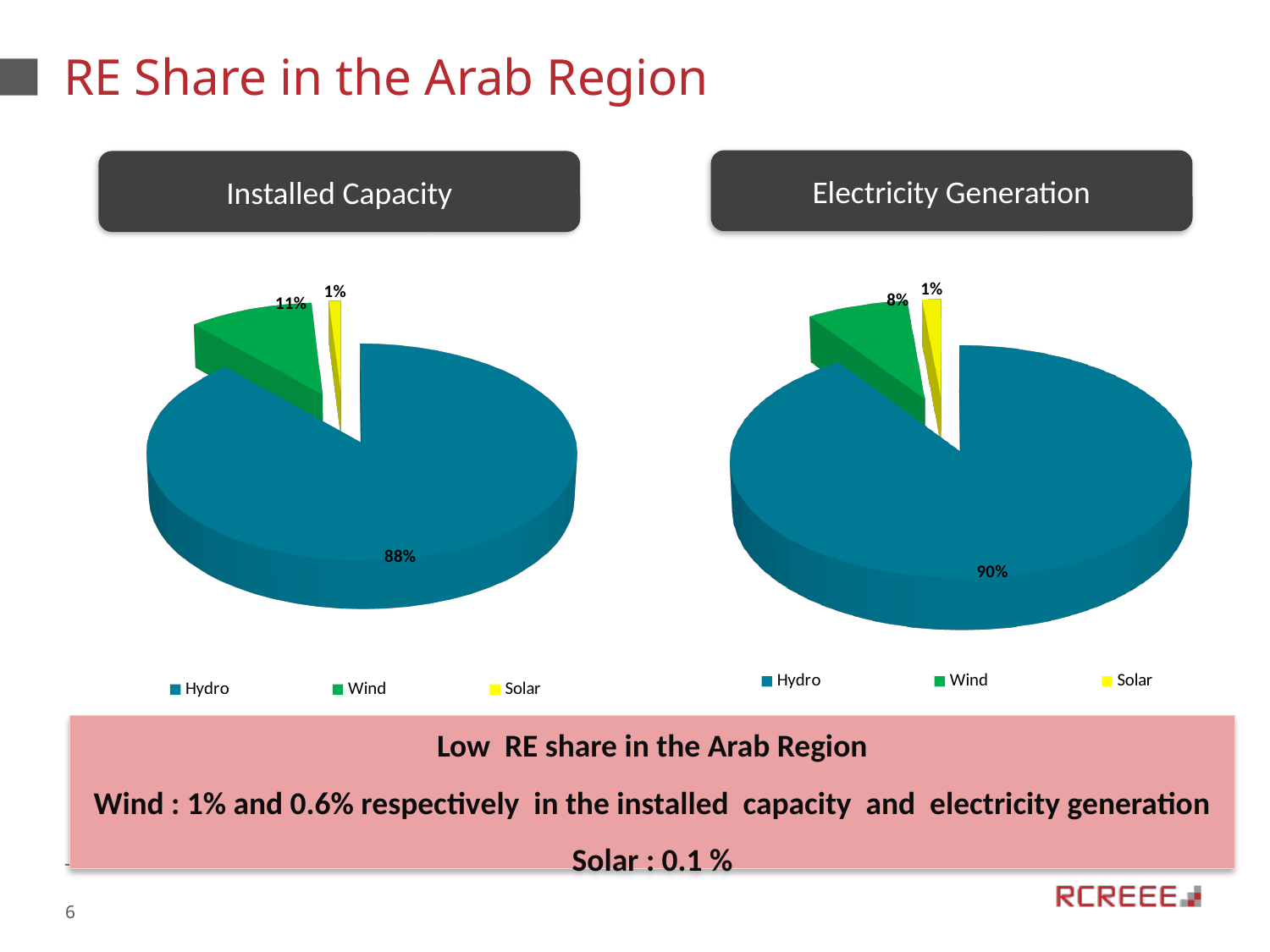
In the Installed Capacity chart, what share does Wind have? 11% What type of chart is the Installed Capacity chart? Pie chart In the Installed Capacity chart, which category has the smallest slice? Solar In the Installed Capacity chart, what share does Hydro have? 88% In the Installed Capacity chart, which colour represents Wind? Green Is the Wind share larger in the Installed Capacity chart or the Electricity Generation chart? Installed Capacity How many categories does the legend of the Electricity Generation chart list? 3 In the Electricity Generation chart, what share does Wind have? 8% In the Electricity Generation chart, which category has the largest slice? Hydro In the Installed Capacity chart, what is the difference between the Hydro and Wind shares? 77% In the Electricity Generation chart, what share does Hydro have? 90% In the Installed Capacity chart, what share does Solar have? 1%